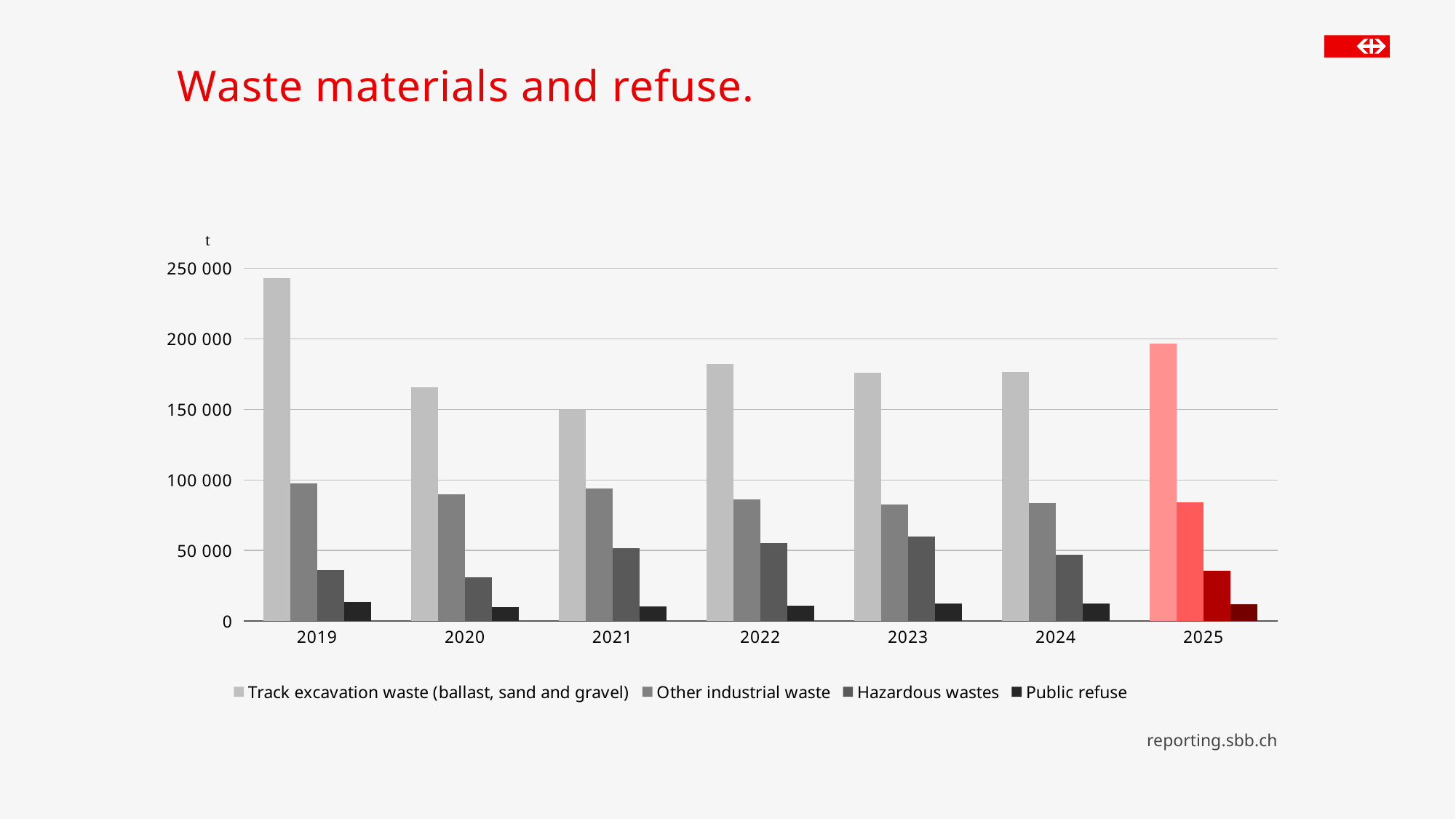
In which year is Track excavation waste (ballast, sand and gravel) highest? 2019 In which year is Hazardous wastes highest? 2023 What kind of chart is shown on the slide? bar chart How many series does the legend list? 4 In which year is Track excavation waste (ballast, sand and gravel) lowest? 2021 Which year's bars are highlighted in red? 2025 How many years are shown on the x axis? 7 Is the value for Hazardous wastes in 2023 greater or less than 50 000? greater Which is larger: Hazardous wastes in 2022 or Hazardous wastes in 2020? 2022 What unit is shown on the vertical axis? t Is the value for Track excavation waste in 2019 greater or less than 200 000? greater